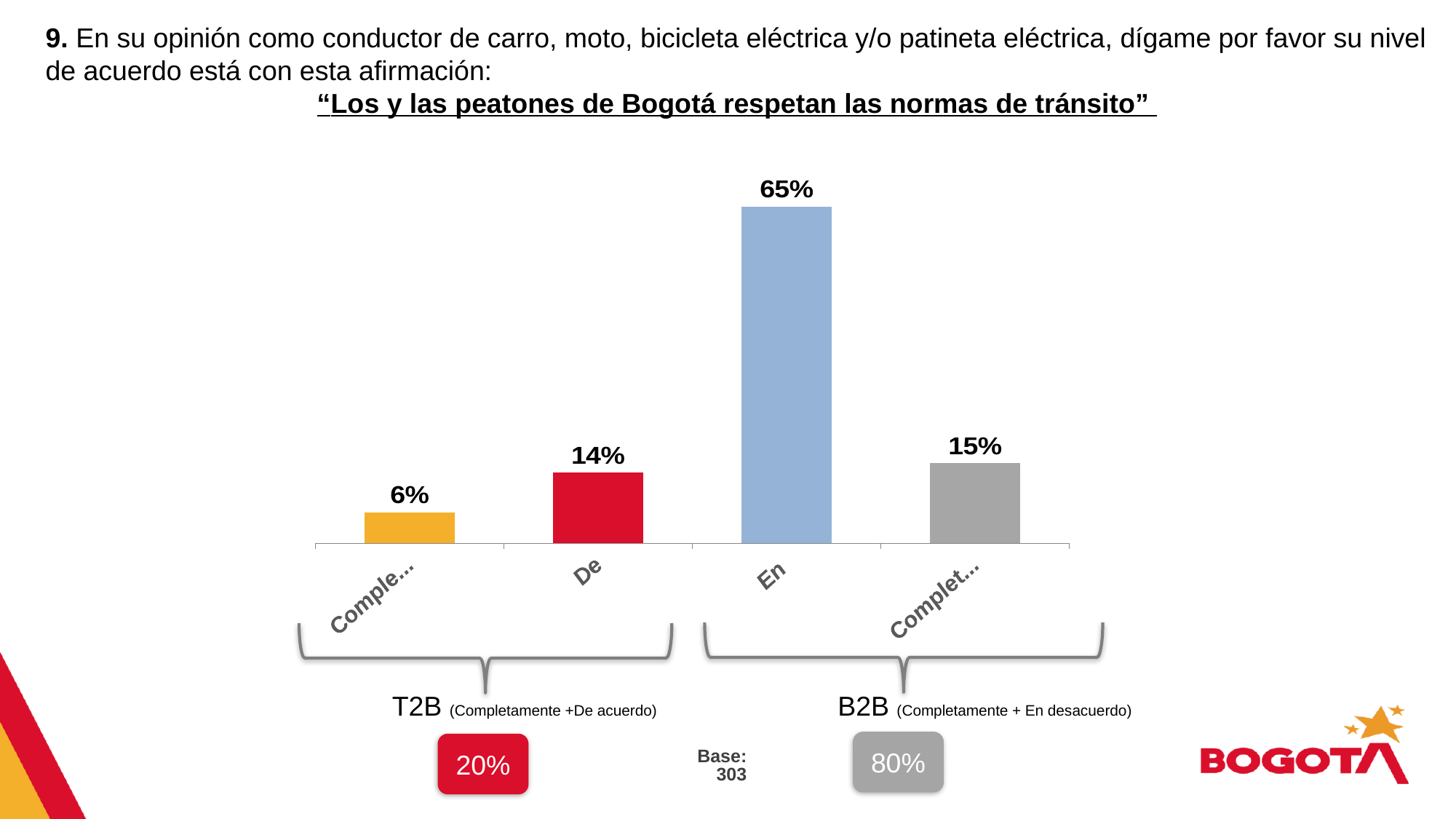
How many bars are plotted in the chart? 4 What type of chart is shown on the slide? bar chart What is the value of the tallest bar in the chart? 65% What is the value of the grey bar on the far right of the chart? 15% What is the value of the shortest bar in the chart? 6% What is the value of the first (yellow) bar on the left of the chart? 6% What is the value of the red bar in the chart? 14% What T2B (Completamente + De acuerdo) percentage is shown below the chart? 20% Which is larger, the red bar or the grey bar? the grey bar What is the value of the blue bar in the chart? 65% What base size is shown below the chart? 303 What is the difference between the blue bar (65%) and the grey bar (15%)? 50%